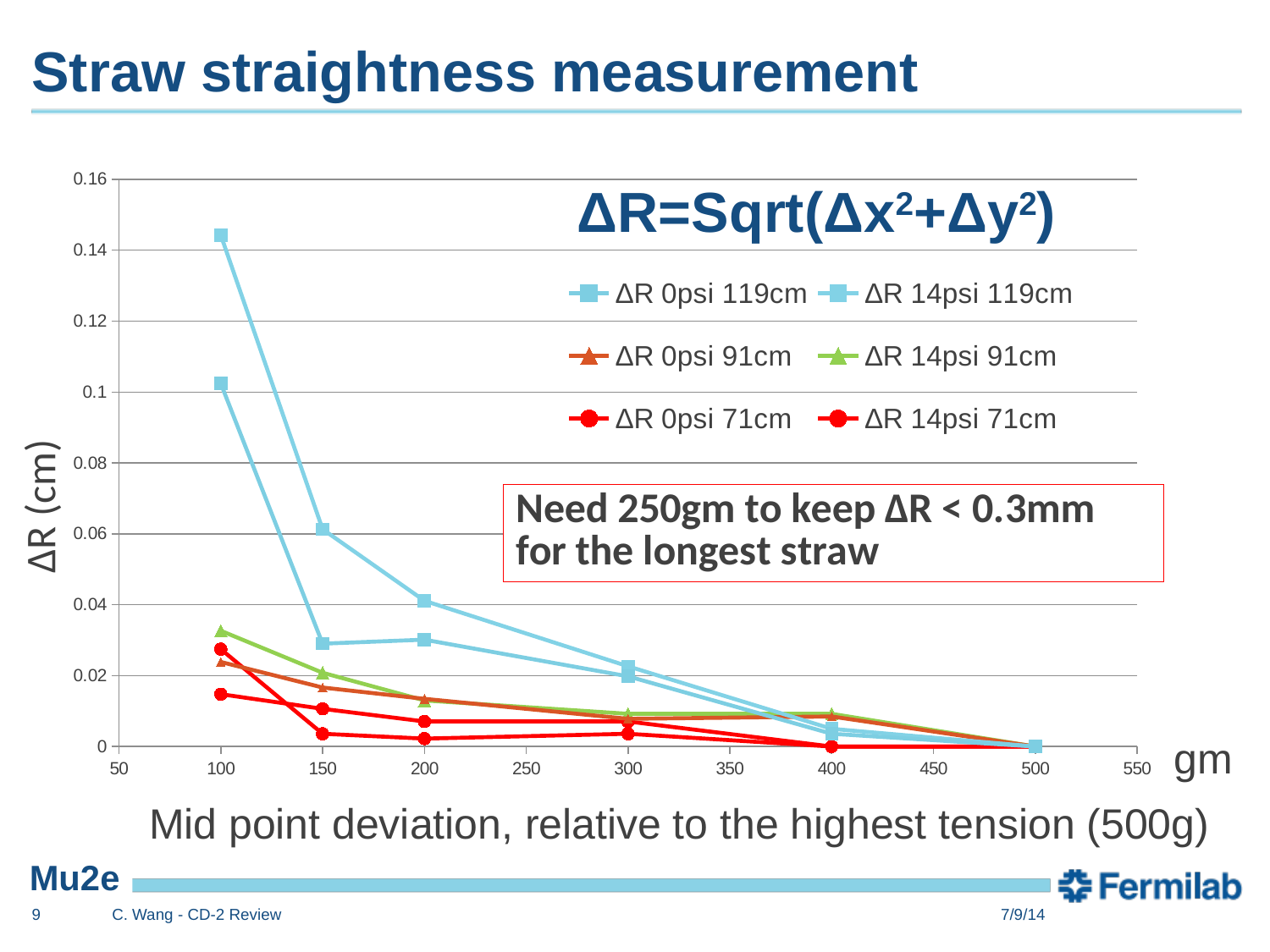
At 100 gm, which is larger: ΔR 14psi 91cm or ΔR 0psi 91cm? ΔR 14psi 91cm At which tension (gm) do the series reach their highest ΔR values? 100 What is the ΔR value for all series at 500 gm? 0 What is the title of the slide containing the chart? Straw straightness measurement How many data points does each series have along the x axis? 6 Is the value for ΔR 0psi 91cm at 200 gm greater or less than 0.02? less How many series does the legend list? 6 Which straw length has the highest ΔR at 100 gm? 119cm Is the highest plotted ΔR value at 100 gm greater or less than 0.14? greater What type of chart is shown on the slide? line chart What is the label of the y axis? ΔR (cm) Do the ΔR values rise or fall as the tension (gm) increases along the x axis? fall